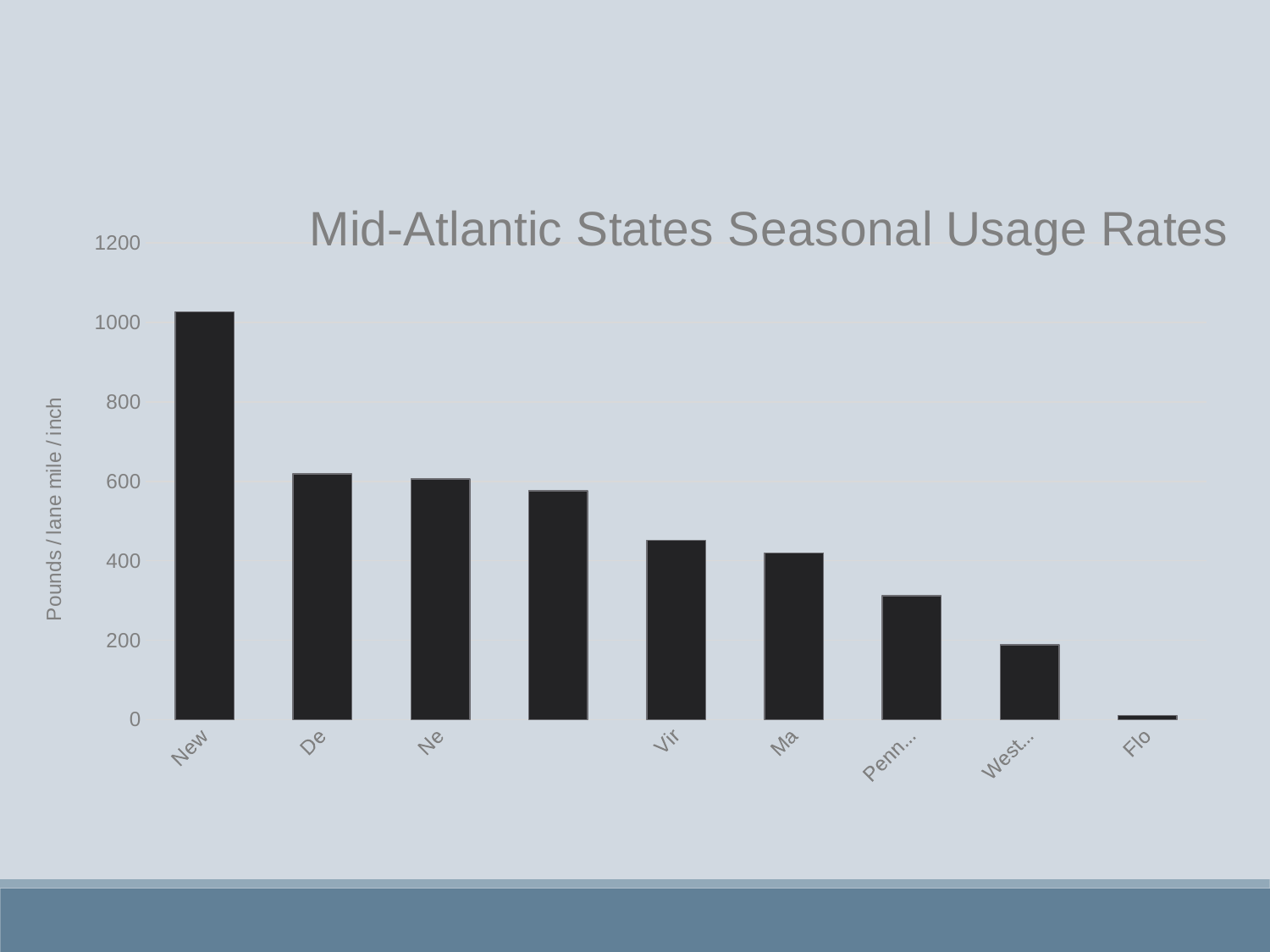
Is the value for De greater or less than 800? less Which category has the highest value in the chart? New Is the value for Flo greater or less than 200? less How many bars are plotted in the chart? 9 Do the values rise or fall moving from left to right along the x axis? fall Which is larger, the value for Vir or the value for Penn...? Vir Is the value for Penn... greater or less than 400? less What is the title of the chart? Mid-Atlantic States Seasonal Usage Rates Which category has the lowest value in the chart? Flo What kind of chart is shown on the slide? bar chart What is the label on the vertical axis of the chart? Pounds / lane mile / inch